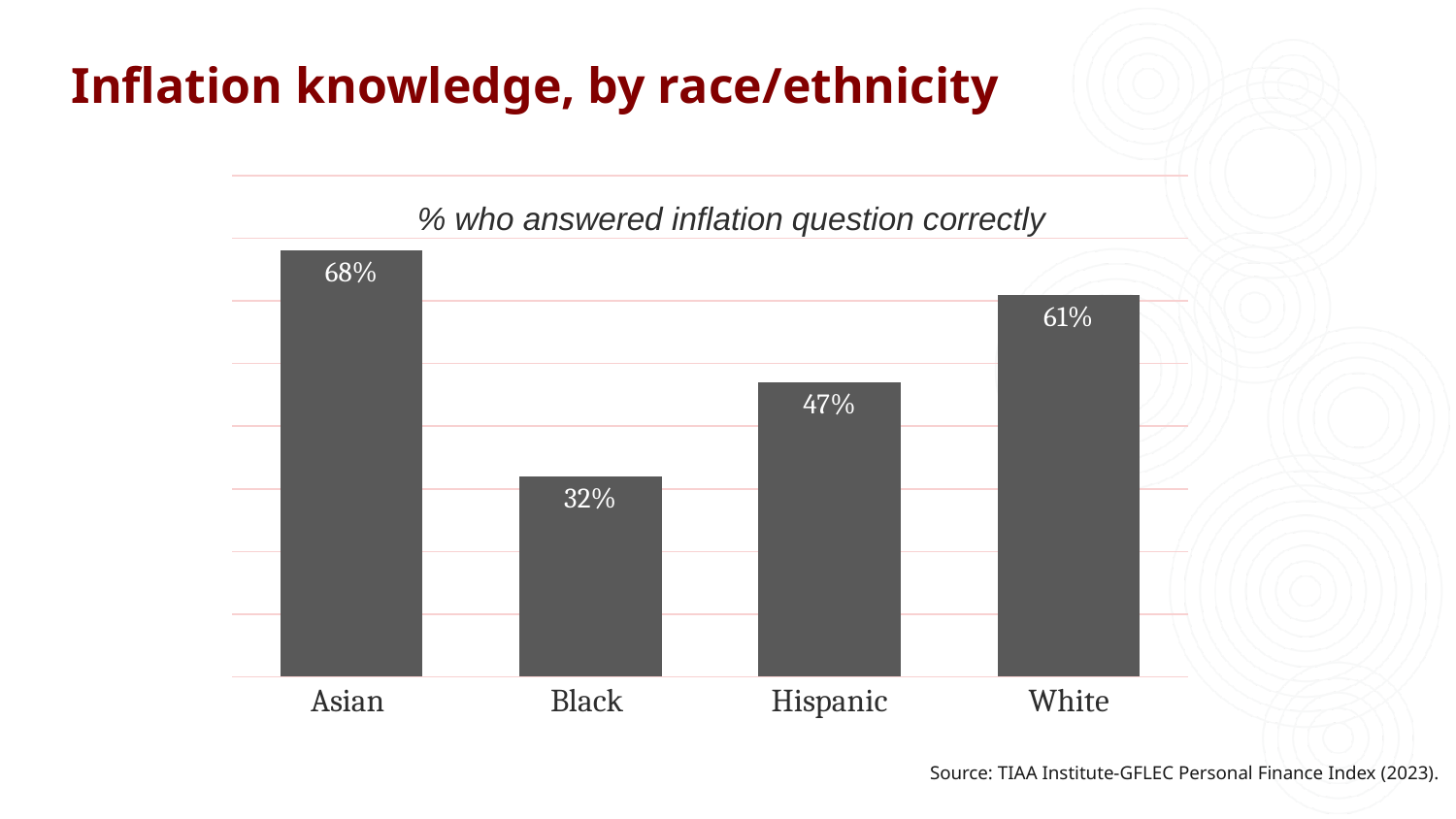
What is the difference between the Asian and Black percentages? 36% What percentage of Asian respondents answered the inflation question correctly? 68% What is the value for White respondents? 61% Which is larger, the value for Hispanic or the value for White? White How many race/ethnicity categories are shown in the chart? 4 Which group has the lowest percentage answering correctly? Black How many percentage points higher is the White value than the Hispanic value? 14 What is the value shown for Black respondents? 32% What is the subtitle printed above the chart? % who answered inflation question correctly What type of chart is shown on the slide? Bar chart What percentage is shown for Hispanic respondents? 47% Which race/ethnicity group has the highest percentage answering the inflation question correctly? Asian